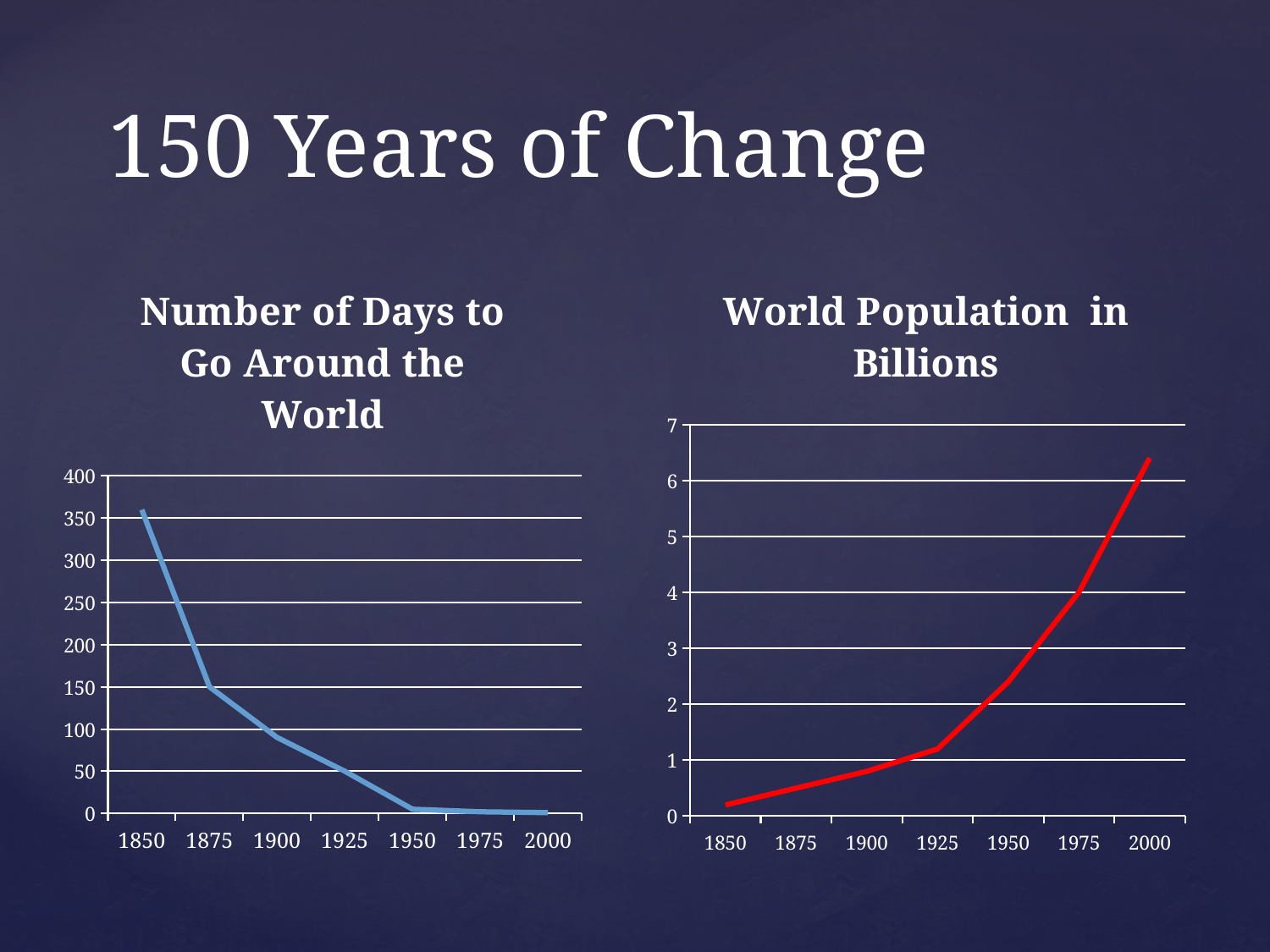
What kind of chart is the 'World Population in Billions' chart? line chart In the 'World Population in Billions' chart, is the value for 1850 greater or less than 1? less In the 'Number of Days to Go Around the World' chart, which year has the highest value? 1850 In the 'World Population in Billions' chart, is the value for 2000 greater or less than 6? greater What kind of chart is the 'Number of Days to Go Around the World' chart? line chart In the 'World Population in Billions' chart, which year has the lowest value? 1850 In the 'World Population in Billions' chart, do the values rise or fall from 1850 to 2000? rise How many years are labelled on the x axis of the 'World Population in Billions' chart? 7 In the 'Number of Days to Go Around the World' chart, is the value for 1850 greater or less than 300? greater In the 'World Population in Billions' chart, which year has the highest value? 2000 In the 'Number of Days to Go Around the World' chart, do the values rise or fall from 1850 to 2000? fall